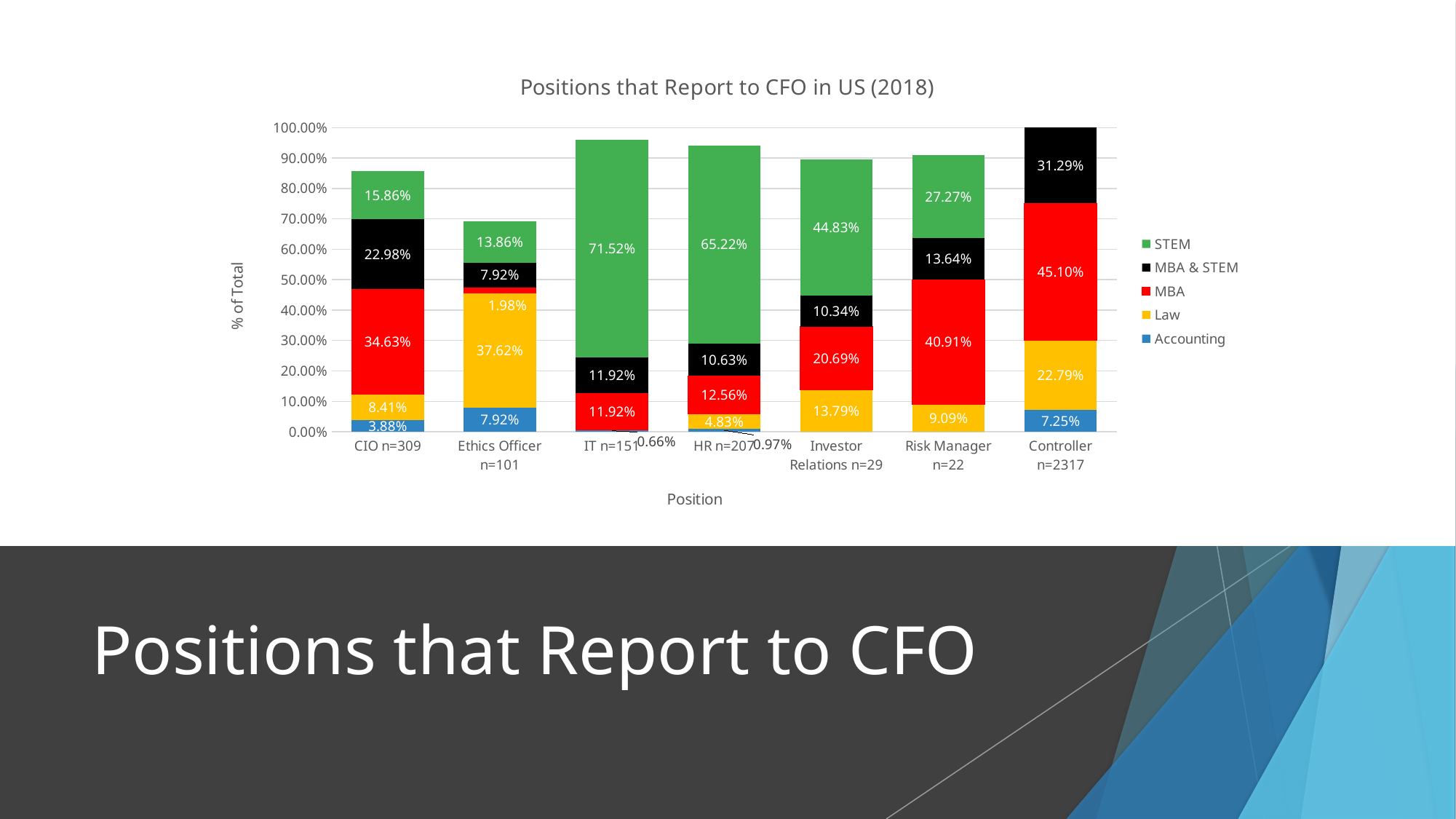
What is the title of the chart? Positions that Report to CFO in US (2018) Which position has the highest STEM value? IT n=151 What is the Law value for Ethics Officer n=101? 37.62% How many series does the legend list? 5 What is the MBA value for Controller n=2317? 45.10% How many positions are shown on the x axis? 7 What is the total of the stacked bar for Risk Manager n=22? 90.91% What is the STEM value for IT n=151? 71.52% What kind of chart is shown on the slide? Stacked bar chart Which position has the lowest MBA value? Ethics Officer n=101 Which is larger, the MBA & STEM value for CIO n=309 or for Controller n=2317? Controller n=2317 What is the difference between the STEM value for IT n=151 and the STEM value for HR n=207? 6.30%